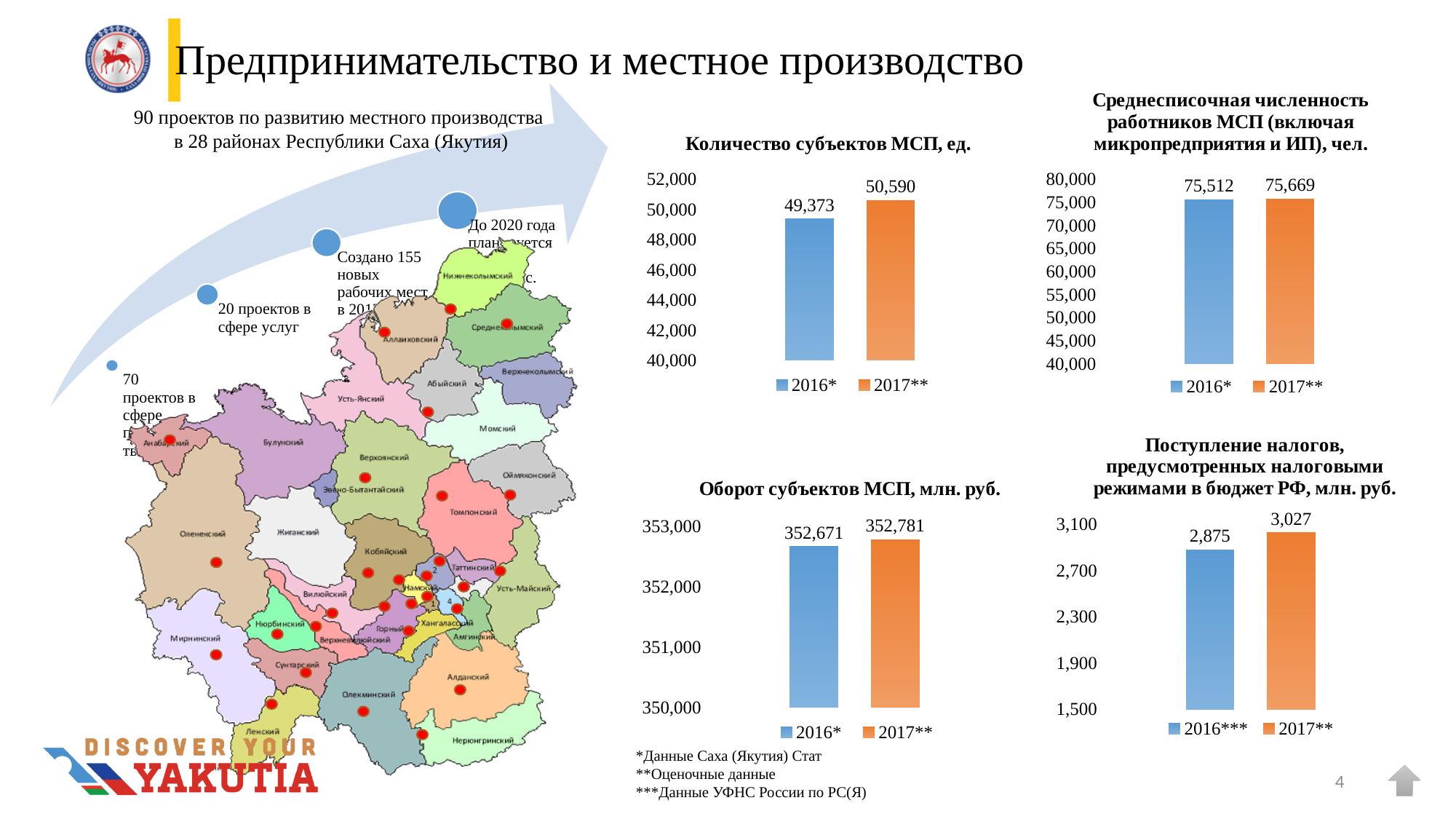
What kind of chart is 'Количество субъектов МСП, ед.'? Bar chart In the chart 'Среднесписочная численность работников МСП (включая микропредприятия и ИП), чел.', what is the value for 2017**? 75,669 In the chart 'Оборот субъектов МСП, млн. руб.', what is the value for 2016*? 352,671 In the chart 'Поступление налогов, предусмотренных налоговыми режимами в бюджет РФ, млн. руб.', what is the value for 2017**? 3,027 In the chart 'Поступление налогов, предусмотренных налоговыми режимами в бюджет РФ, млн. руб.', what is the difference between the 2017** and 2016*** values? 152 In the chart 'Оборот субъектов МСП, млн. руб.', what is the difference between the 2017** and 2016* values? 110 In the chart 'Количество субъектов МСП, ед.', what is the value for 2016*? 49,373 In the chart 'Количество субъектов МСП, ед.', what is the value for 2017**? 50,590 In the chart 'Поступление налогов, предусмотренных налоговыми режимами в бюджет РФ, млн. руб.', which year has the higher value? 2017** How many series does the legend of the chart 'Оборот субъектов МСП, млн. руб.' list? 2 In the chart 'Среднесписочная численность работников МСП (включая микропредприятия и ИП), чел.', what is the value for 2016*? 75,512 In the chart 'Количество субъектов МСП, ед.', what is the difference between the 2017** and 2016* values? 1,217